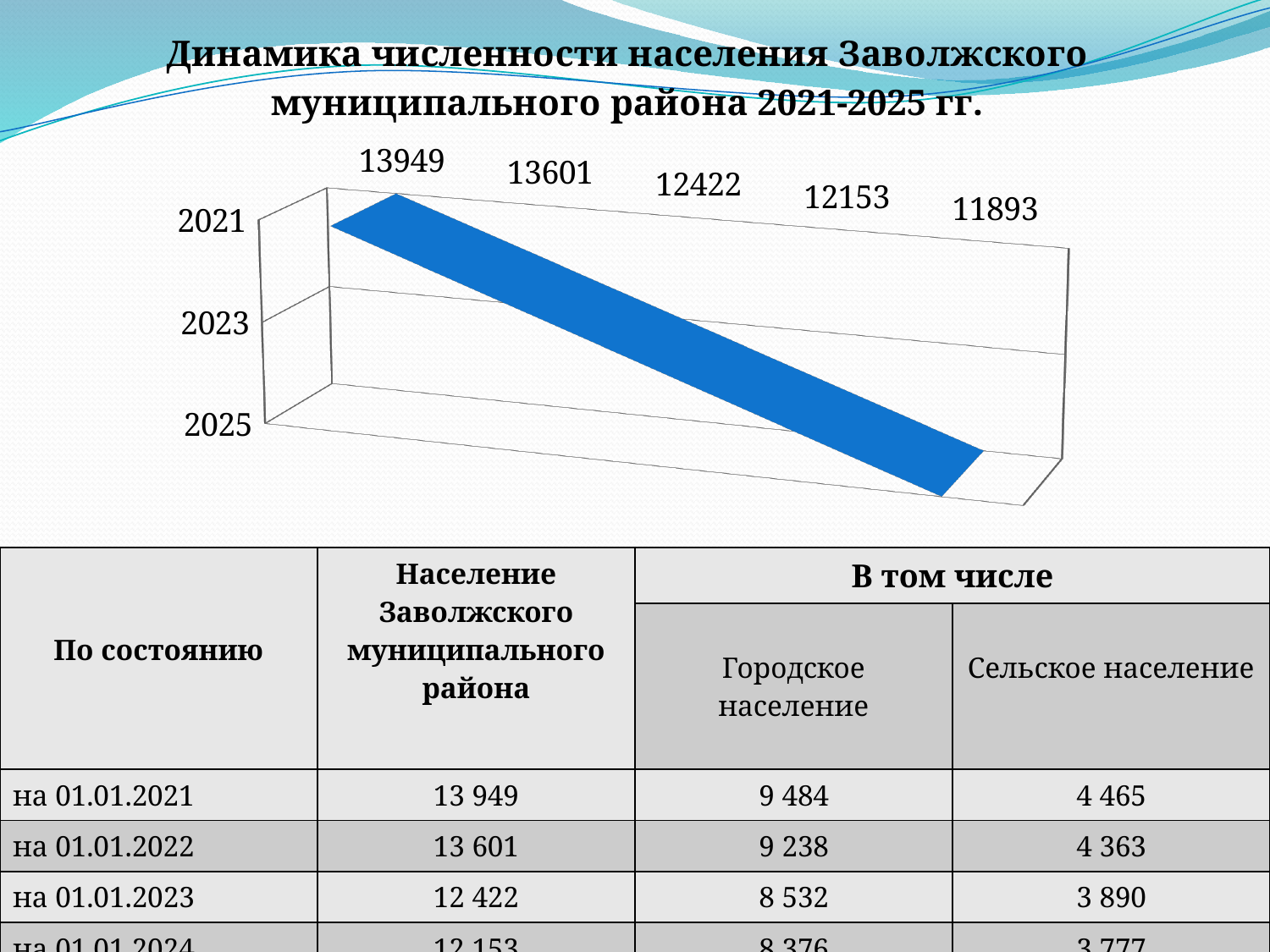
What is the difference between the population values for 2023 and 2025 on the chart? 529 How many data labels (data points) are shown on the chart? 5 Which is larger on the chart, the population value for 2023 or for 2025? 2023 What is the population value shown for 2023 on the chart? 12422 What is the difference between the population values for 2021 and 2025 on the chart? 2056 What is the title of the chart on the slide? Динамика численности населения Заволжского муниципального района 2021-2025 гг. Do the population values on the chart rise or fall from 2021 to 2025? fall What is the population value shown for 2021 on the chart? 13949 What is the population value shown for 2025 on the chart? 11893 Which year on the chart has the lowest population value? 2025 Which year on the chart has the highest population value? 2021 What is the difference between the population values for 2021 and 2023 on the chart? 1527